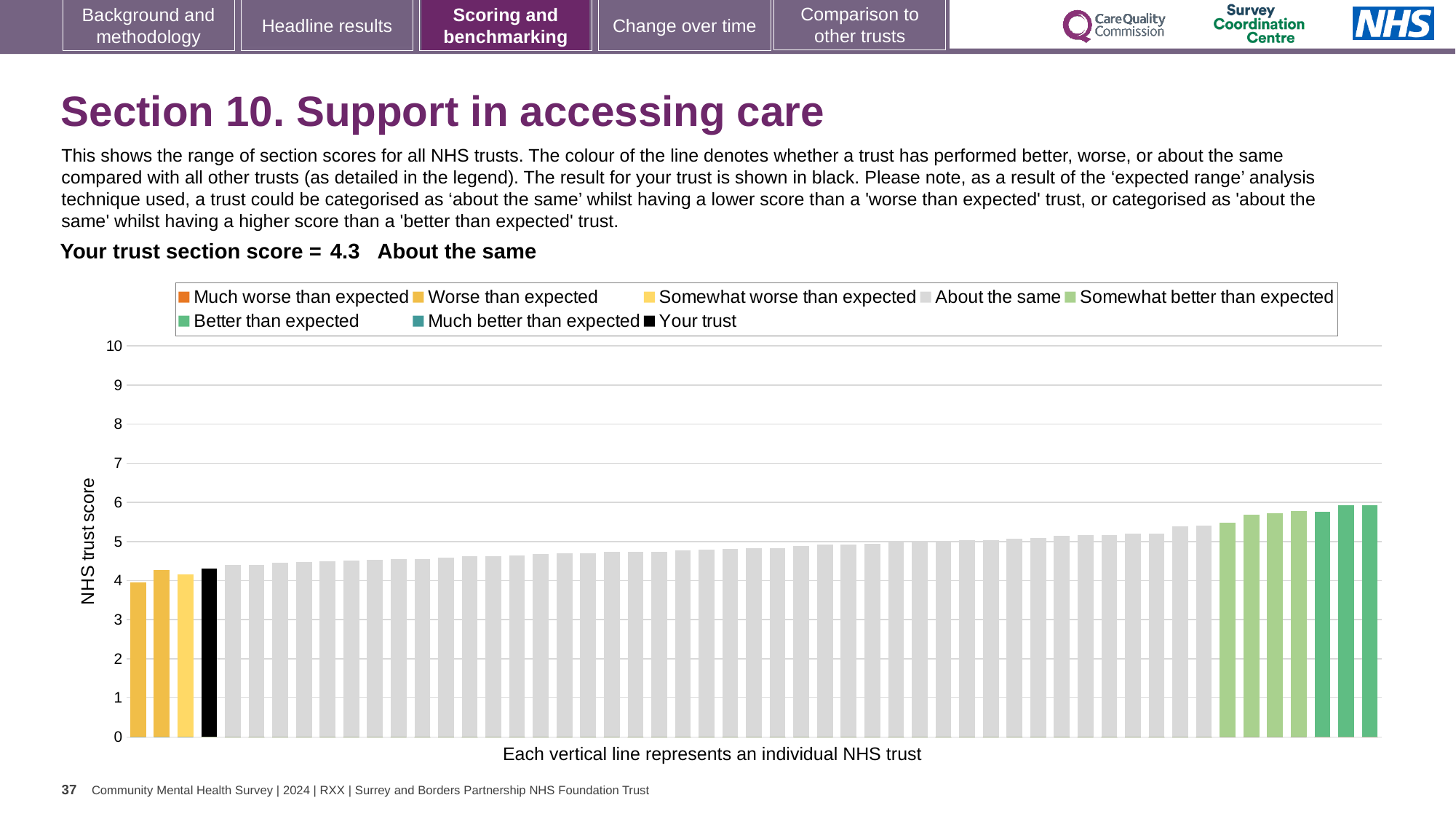
How many bars are coloured in the 'Somewhat better than expected' (light green) colour? 4 What is the label of the y axis? NHS trust score Is the value for the black 'Your trust' bar greater or less than 5? less Do the bar values rise or fall from left to right along the x axis? Rise What kind of chart is shown on the slide? Bar chart How many bars are coloured in the 'Better than expected' (darker green) colour? 3 Is the value of the tallest bar greater or less than 5? greater What is the maximum value shown on the y axis? 10 What is the trust's section score shown on the slide? 4.3 Which category does the trust's section score fall into according to the slide? About the same How many entries does the chart legend list? 8